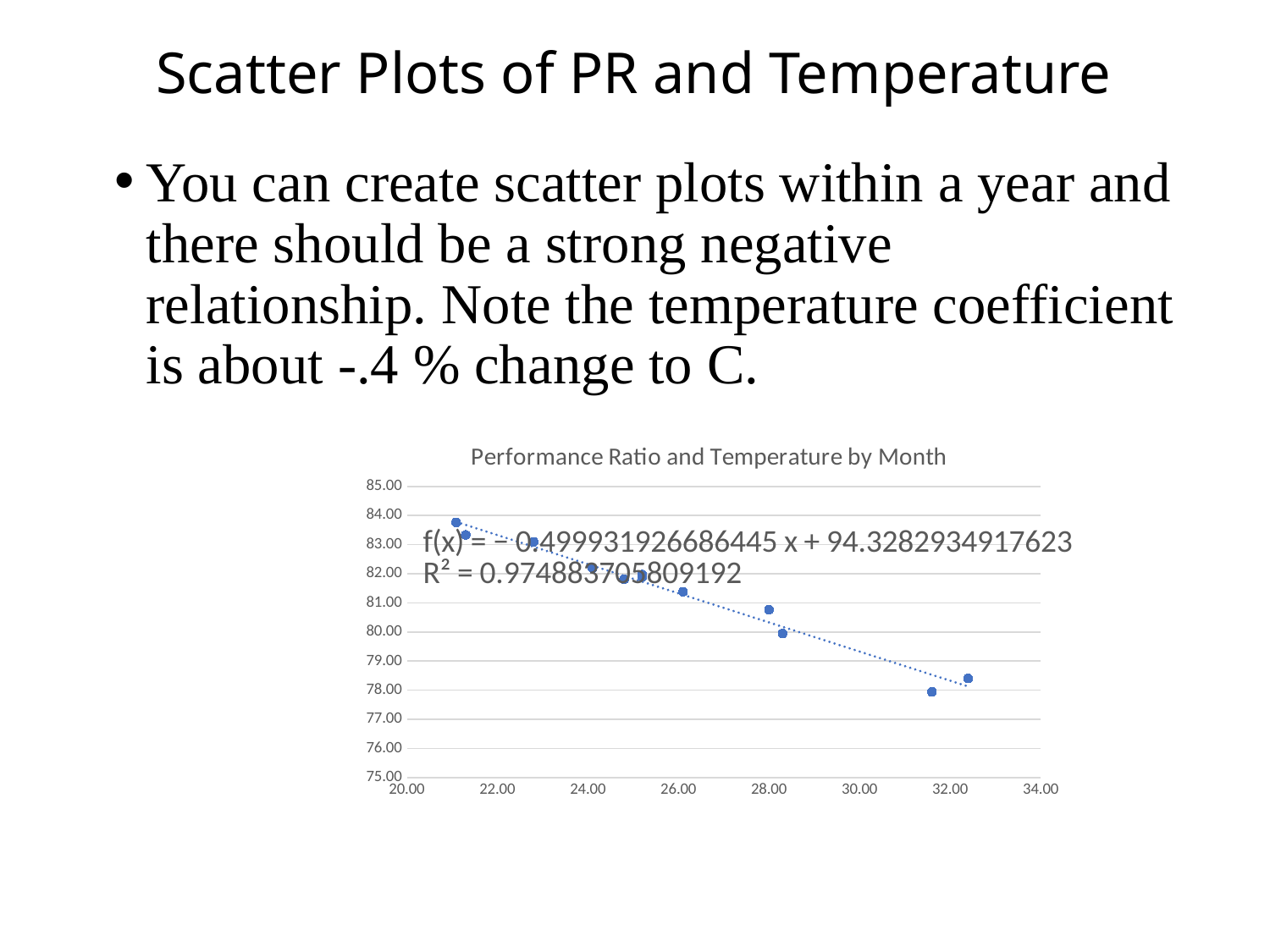
Is the performance ratio for the point at about 26.00 on the x axis greater or less than 81.00? greater What is the intercept of the trend line equation printed on the chart? 94.3282934917623 What kind of chart is shown on the slide? Scatter plot Is the performance ratio for the leftmost point (near 21.00) greater or less than 83.00? greater What is the title of the chart? Performance Ratio and Temperature by Month Which has the higher performance ratio: the point near 21.00 or the point near 32.00 on the x axis? The point near 21.00 Is the performance ratio for the point at about 26.00 on the x axis greater or less than 82.00? less What is the slope of the trend line equation printed on the chart? -0.499931926686445 What R² value is printed on the chart? R² = 0.974883705809192 Do the plotted values rise or fall as temperature increases along the x axis? Fall What is the highest value shown on the y axis? 85.00